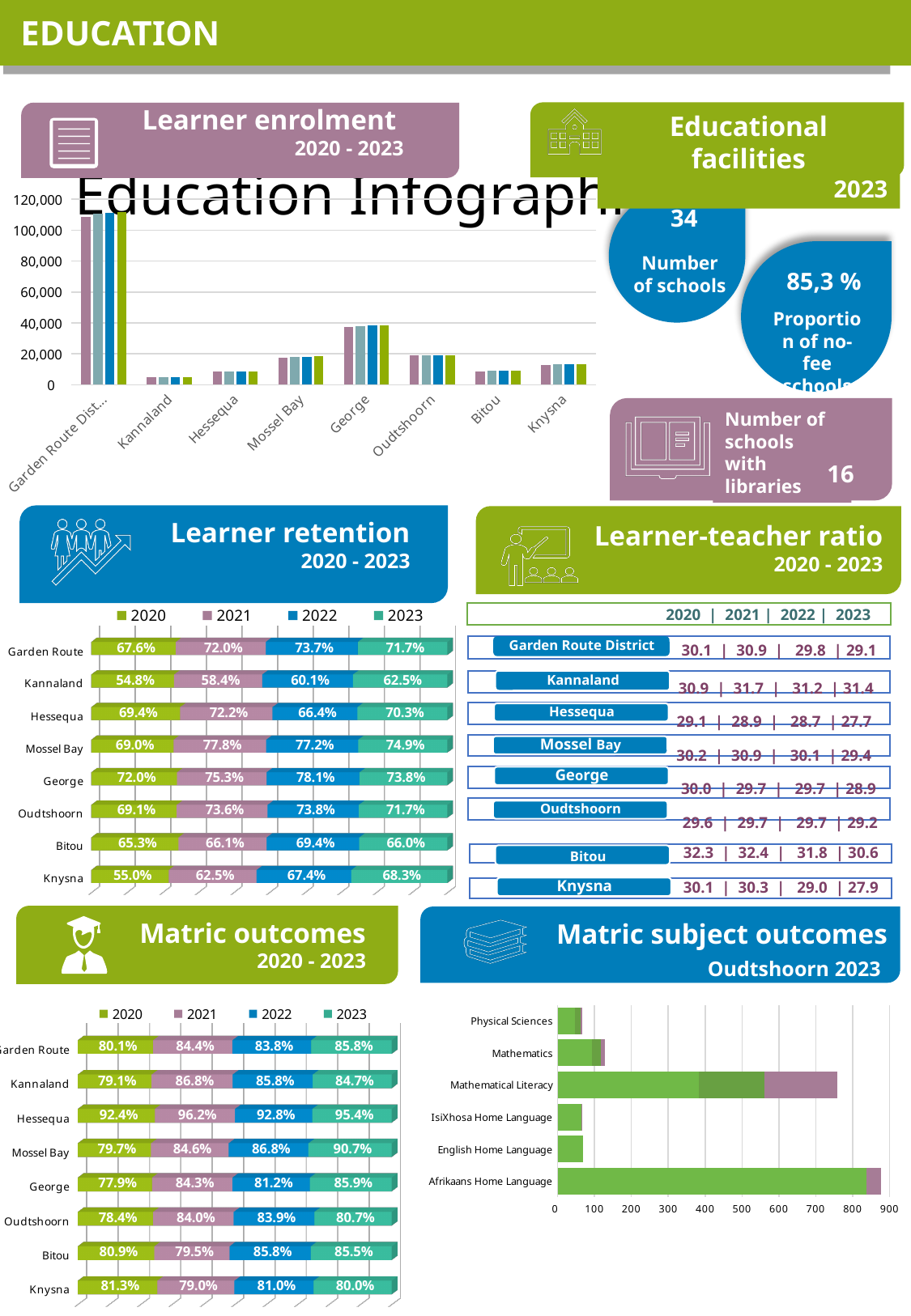
In the Matric outcomes chart, how many municipalities are shown? 8 In the Learner retention chart, what is the 2022 value for Kannaland? 60.1% In the Learner retention chart, how many series does the legend list? 4 In the Learner retention chart, what is the difference between the 2023 and 2020 values for Knysna? 13.3 percentage points In the Learner retention chart, which municipality has the lowest 2020 value? Kannaland In the Matric outcomes chart, what is the 2021 value for Hessequa? 96.2% What kind of chart is the Matric subject outcomes chart? bar chart In the Learner enrolment chart, is the value for Garden Route District greater or less than 100,000? greater In the Matric outcomes chart, which municipality has the highest 2023 value? Hessequa In the Matric subject outcomes chart, is the value for Afrikaans Home Language greater or less than 800? greater In the Matric outcomes chart, is the 2022 value for Bitou larger or smaller than the 2022 value for Knysna? larger